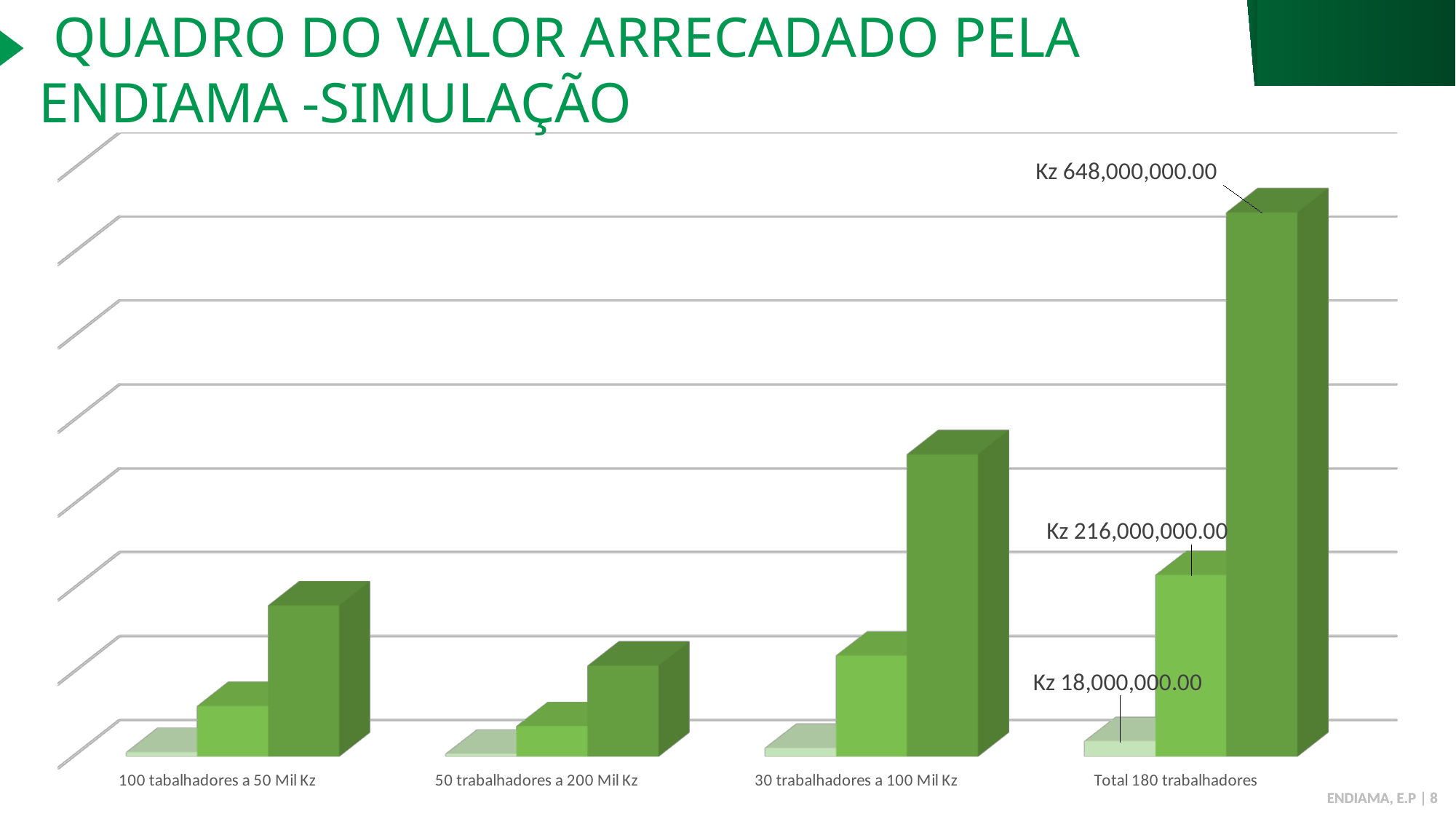
Which category has the shortest bars in the chart? 50 trabalhadores a 200 Mil Kz What is the value labelled on the middle-height bar for 'Total 180 trabalhadores'? Kz 216,000,000.00 How many bars are drawn for each category in the chart? 3 What is the value labelled on the shortest bar for 'Total 180 trabalhadores'? Kz 18,000,000.00 What is the difference between the labelled values Kz 216,000,000.00 and Kz 18,000,000.00 for 'Total 180 trabalhadores'? Kz 198,000,000.00 Which category has the tallest bar in the chart? Total 180 trabalhadores Which category has a taller tallest bar: '30 trabalhadores a 100 Mil Kz' or '100 tabalhadores a 50 Mil Kz'? 30 trabalhadores a 100 Mil Kz What is the value labelled on the tallest bar for 'Total 180 trabalhadores'? Kz 648,000,000.00 What kind of chart is shown on the slide? bar chart What is the title of the slide containing the chart? QUADRO DO VALOR ARRECADADO PELA ENDIAMA -SIMULAÇÃO What is the difference between the two largest labelled values for 'Total 180 trabalhadores' (Kz 648,000,000.00 and Kz 216,000,000.00)? Kz 432,000,000.00 How many categories are shown along the x axis of the chart? 4